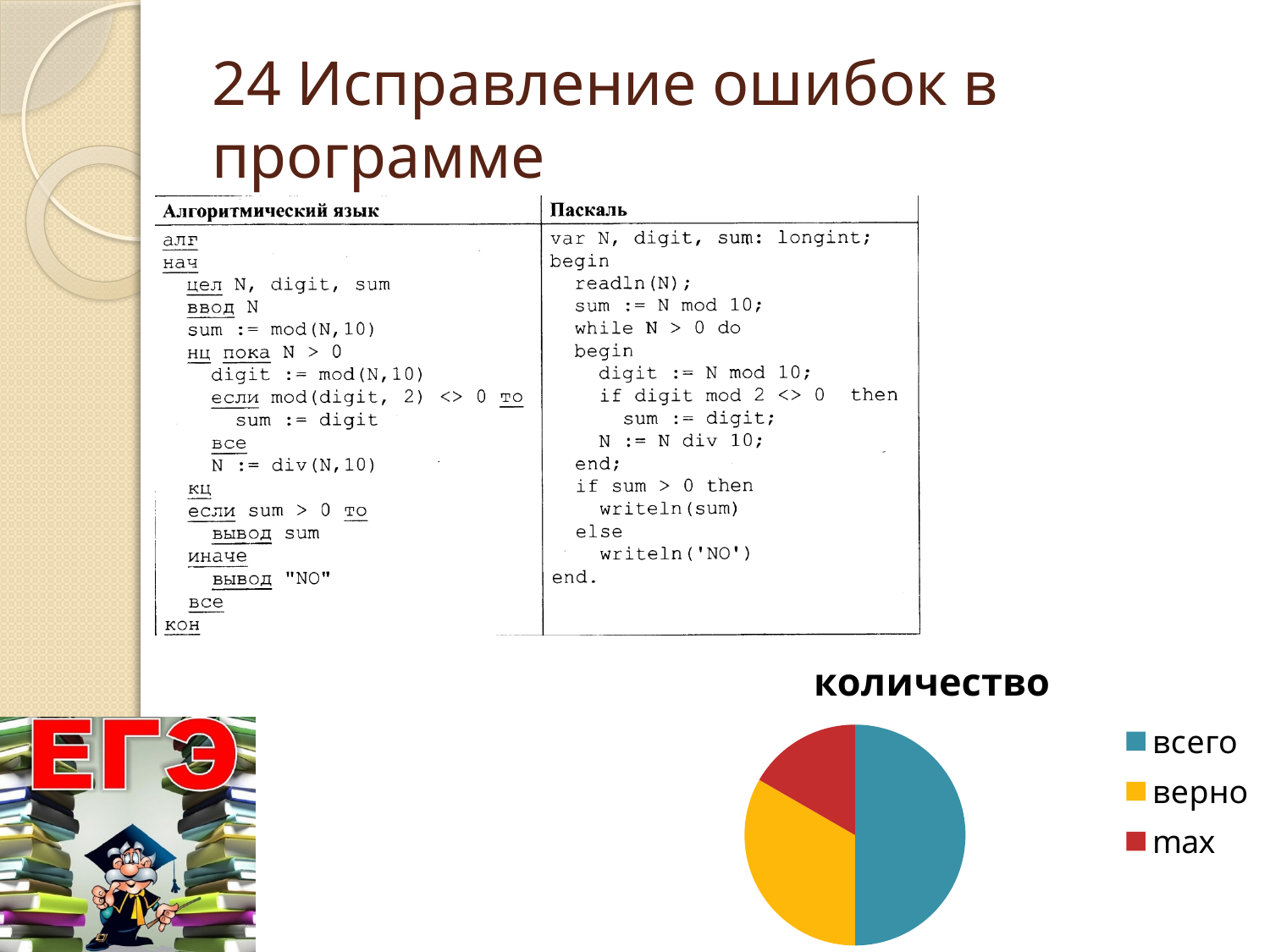
Which slice is larger in the pie chart, всего or max? всего How many entries does the legend of the pie chart list? 3 What kind of chart is shown on the slide? pie chart What colour is the slice for верно in the pie chart? yellow Which category has the largest slice in the pie chart? всего Which slice is larger in the pie chart, верно or max? верно How many slices does the pie chart have? 3 Which slice is larger in the pie chart, всего or верно? всего Which category has the smallest slice in the pie chart? max What is the title of the pie chart? количество